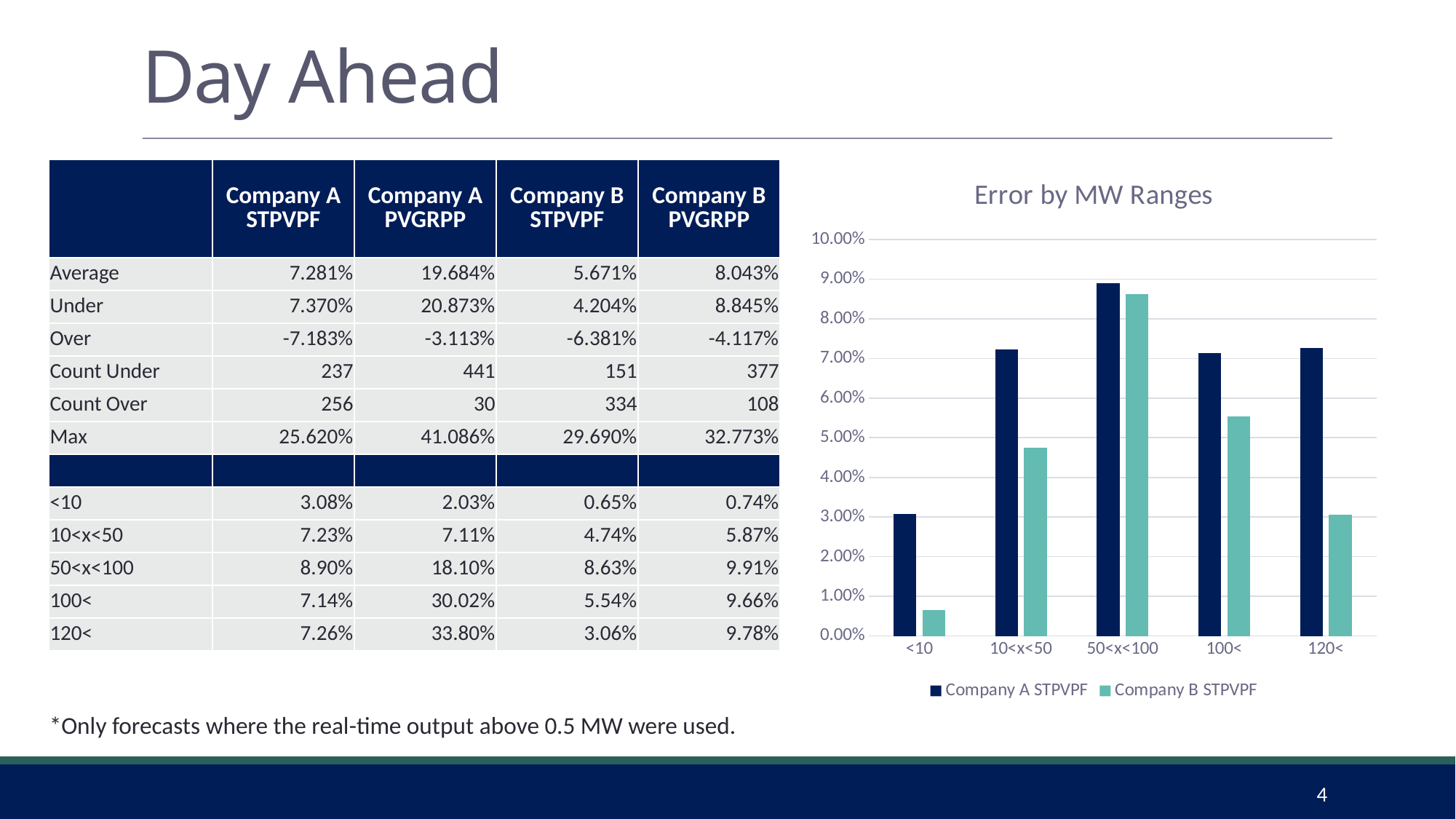
For which MW range is the Company B STPVPF bar the lowest? <10 Is the Company B STPVPF value for <10 greater or less than 1.00%? less How many series does the chart legend list? 2 What kind of chart is shown on the slide? bar chart In the <10 range, which series has the larger bar, Company A STPVPF or Company B STPVPF? Company A STPVPF Is the Company A STPVPF value for 50<x<100 greater or less than 8.00%? greater Which series in the chart is drawn in dark navy bars? Company A STPVPF How many MW range categories are shown on the x axis of the chart? 5 What is the title of the chart on the slide? Error by MW Ranges For which MW range is the Company B STPVPF bar the highest? 50<x<100 Is the Company B STPVPF value for 100< greater or less than 5.00%? greater For which MW range is the Company A STPVPF bar the highest? 50<x<100